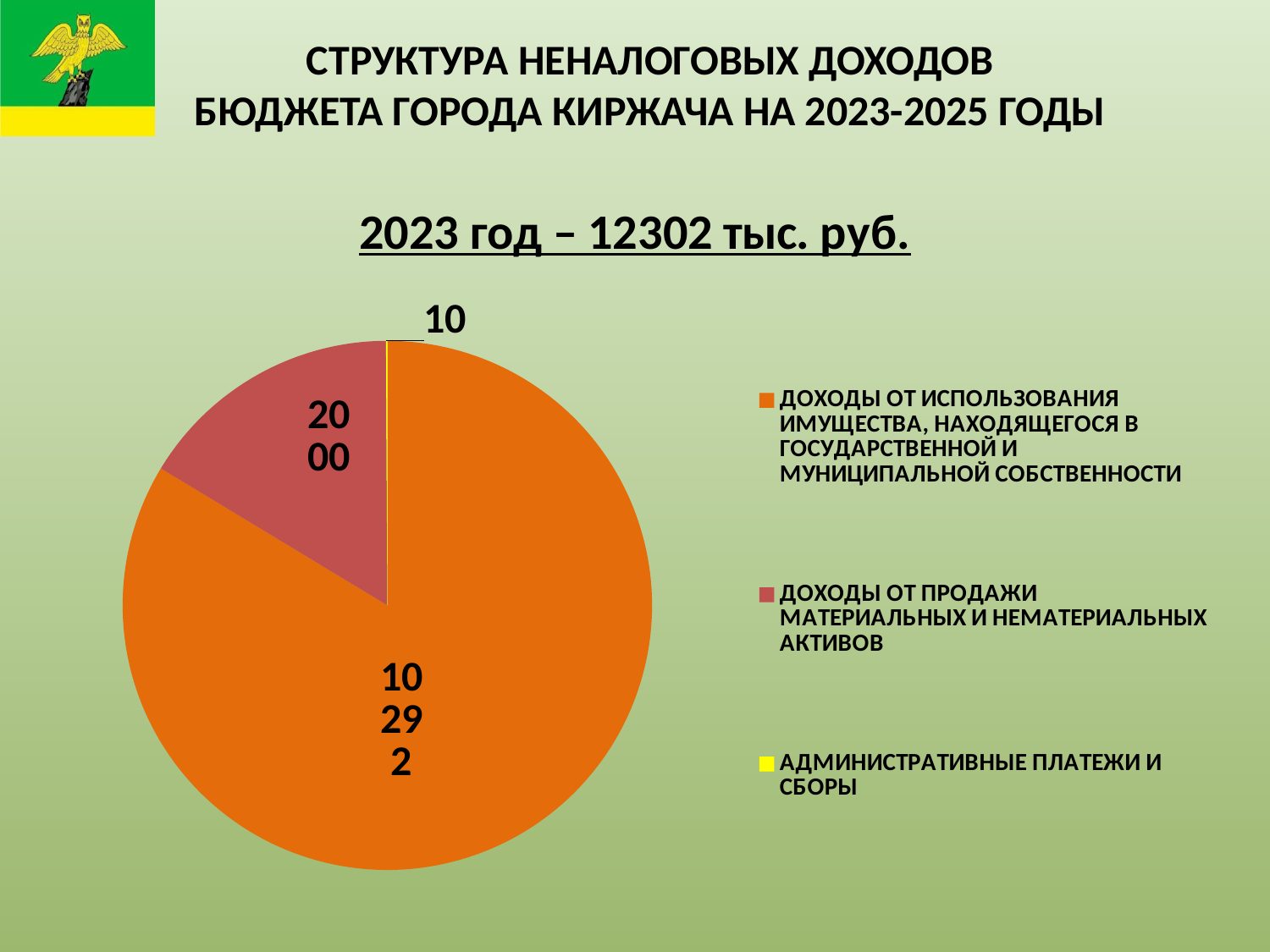
Which category has the smallest slice in the pie chart? АДМИНИСТРАТИВНЫЕ ПЛАТЕЖИ И СБОРЫ Which is larger: the slice for ДОХОДЫ ОТ ПРОДАЖИ МАТЕРИАЛЬНЫХ И НЕМАТЕРИАЛЬНЫХ АКТИВОВ or the slice for АДМИНИСТРАТИВНЫЕ ПЛАТЕЖИ И СБОРЫ? ДОХОДЫ ОТ ПРОДАЖИ МАТЕРИАЛЬНЫХ И НЕМАТЕРИАЛЬНЫХ АКТИВОВ What is the value of the slice for ДОХОДЫ ОТ ИСПОЛЬЗОВАНИЯ ИМУЩЕСТВА, НАХОДЯЩЕГОСЯ В ГОСУДАРСТВЕННОЙ И МУНИЦИПАЛЬНОЙ СОБСТВЕННОСТИ? 10292 What colour is the slice for АДМИНИСТРАТИВНЫЕ ПЛАТЕЖИ И СБОРЫ? yellow What is the difference between the value for ДОХОДЫ ОТ ИСПОЛЬЗОВАНИЯ ИМУЩЕСТВА and the value for ДОХОДЫ ОТ ПРОДАЖИ МАТЕРИАЛЬНЫХ И НЕМАТЕРИАЛЬНЫХ АКТИВОВ? 8292 What is the value of the slice for ДОХОДЫ ОТ ПРОДАЖИ МАТЕРИАЛЬНЫХ И НЕМАТЕРИАЛЬНЫХ АКТИВОВ? 2000 What is the difference between the value for ДОХОДЫ ОТ ПРОДАЖИ МАТЕРИАЛЬНЫХ И НЕМАТЕРИАЛЬНЫХ АКТИВОВ and the value for АДМИНИСТРАТИВНЫЕ ПЛАТЕЖИ И СБОРЫ? 1990 What kind of chart is shown on the slide? pie chart Which category has the largest slice in the pie chart? ДОХОДЫ ОТ ИСПОЛЬЗОВАНИЯ ИМУЩЕСТВА, НАХОДЯЩЕГОСЯ В ГОСУДАРСТВЕННОЙ И МУНИЦИПАЛЬНОЙ СОБСТВЕННОСТИ How many entries does the legend of the pie chart list? 3 How many slices does the pie chart have? 3 What is the value of the slice for АДМИНИСТРАТИВНЫЕ ПЛАТЕЖИ И СБОРЫ? 10